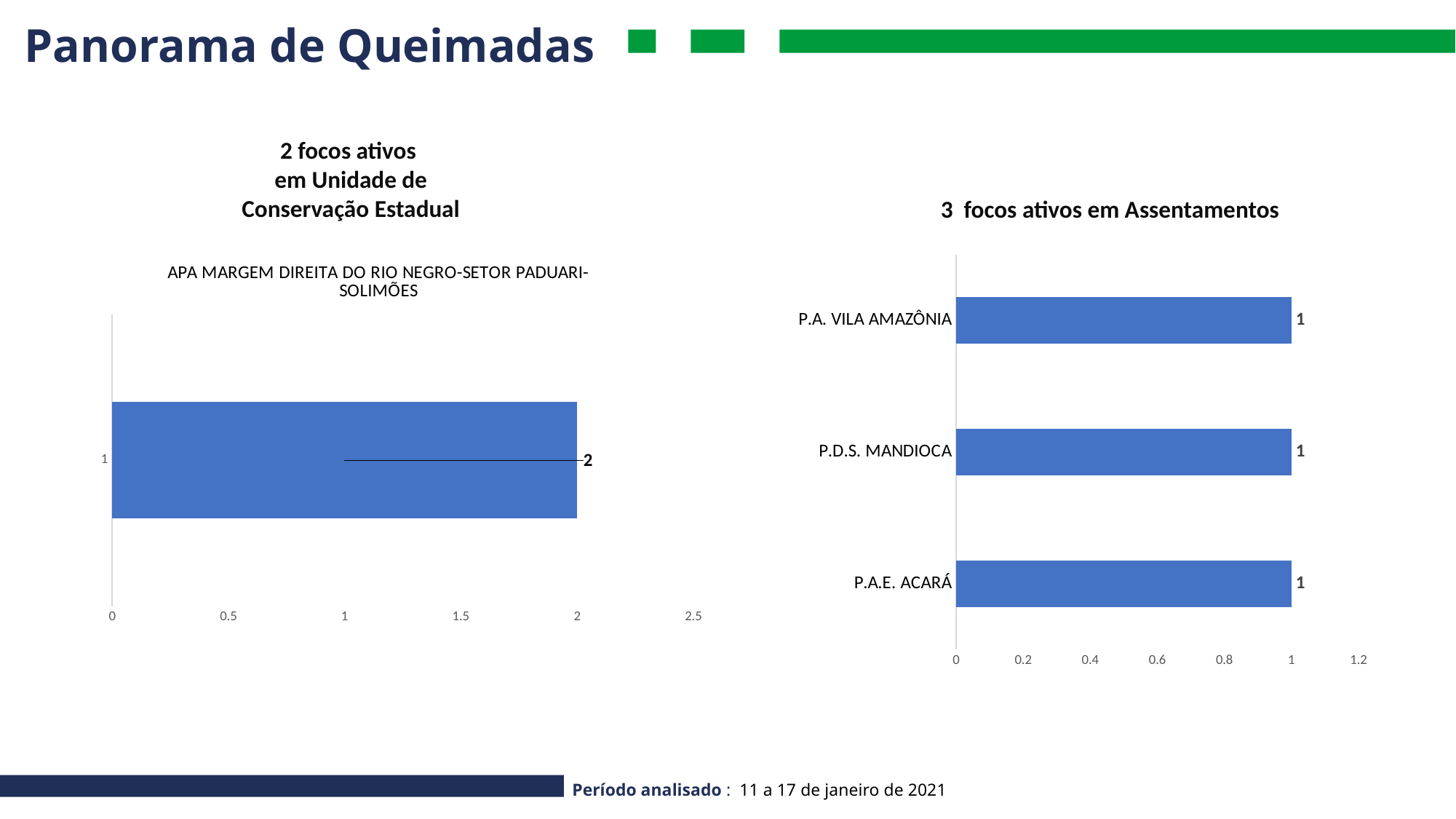
In the chart titled 'APA MARGEM DIREITA DO RIO NEGRO-SETOR PADUARI-SOLIMÕES', how many bars are plotted? 1 In the chart titled '3 focos ativos em Assentamentos', what is the total of the three bar values? 3 In the chart titled 'APA MARGEM DIREITA DO RIO NEGRO-SETOR PADUARI-SOLIMÕES', what is the value of the bar? 2 Which is larger: the bar in the chart titled 'APA MARGEM DIREITA DO RIO NEGRO-SETOR PADUARI-SOLIMÕES' or the bar for P.A.E. ACARÁ in the chart titled '3 focos ativos em Assentamentos'? APA MARGEM DIREITA DO RIO NEGRO-SETOR PADUARI-SOLIMÕES In the chart titled '3 focos ativos em Assentamentos', how many categories are plotted? 3 In the chart titled '3 focos ativos em Assentamentos', what is the value for P.A.E. ACARÁ? 1 In the chart titled 'APA MARGEM DIREITA DO RIO NEGRO-SETOR PADUARI-SOLIMÕES', what kind of chart is shown? Bar chart In the chart titled '3 focos ativos em Assentamentos', what is the value for P.D.S. MANDIOCA? 1 In the chart titled 'APA MARGEM DIREITA DO RIO NEGRO-SETOR PADUARI-SOLIMÕES', is the bar value greater or less than 1.5? greater In the chart titled '3 focos ativos em Assentamentos', what is the highest value shown on the x axis? 1.2 In the chart titled '3 focos ativos em Assentamentos', what is the value for P.A. VILA AMAZÔNIA? 1 In the chart titled '3 focos ativos em Assentamentos', what kind of chart is shown? Bar chart